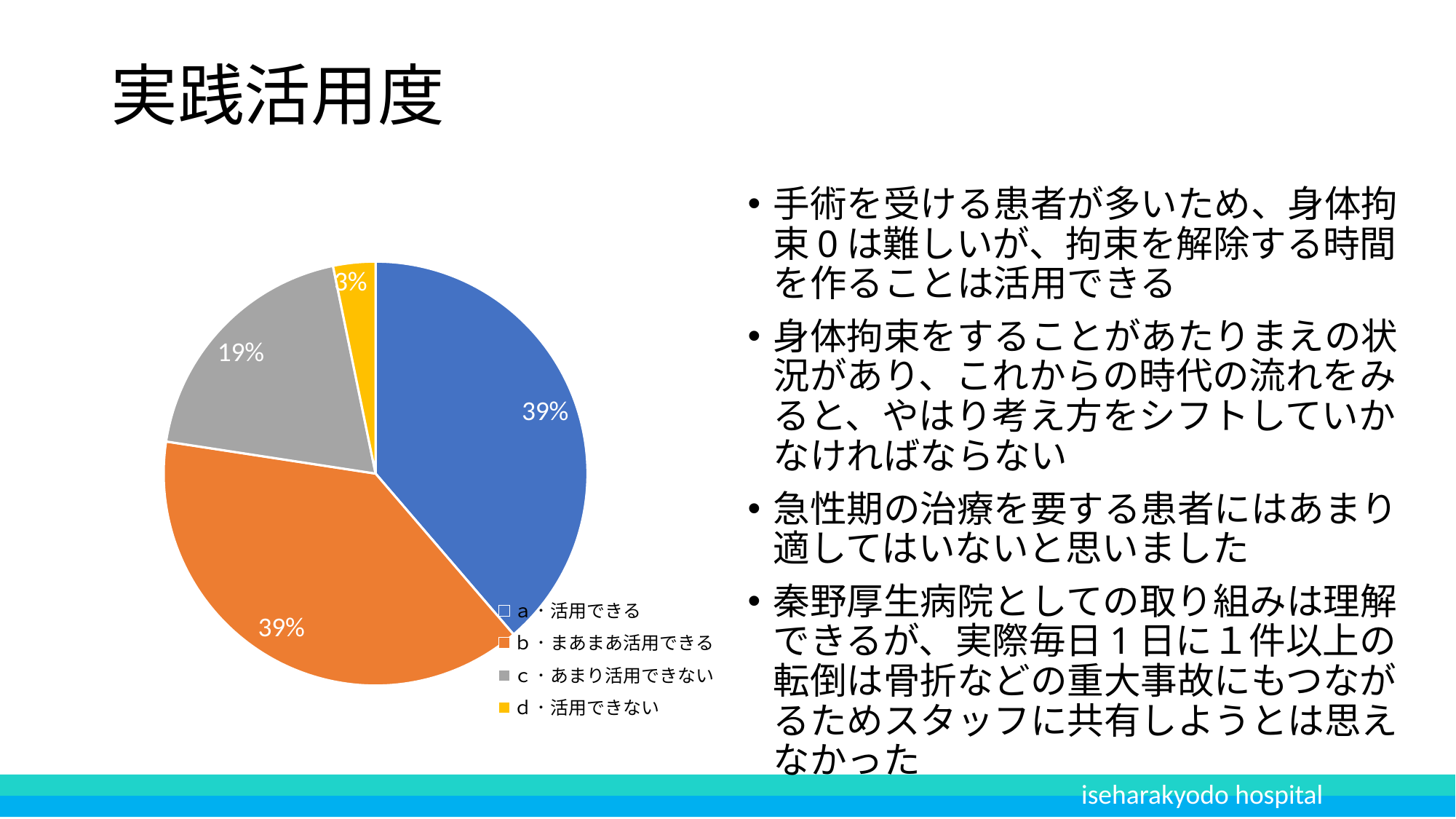
What percentage of the pie is labelled for 'b・まあまあ活用できる'? 39% How many slices does the pie chart have? 4 What percentage of the pie is labelled for 'c・あまり活用できない'? 19% What percentage of the pie is labelled for 'a・活用できる'? 39% How many entries does the legend list? 4 Which category has the smallest slice of the pie? d・活用できない What is the difference in percentage points between 'a・活用できる' and 'c・あまり活用できない'? 20 Which slice is larger, 'c・あまり活用できない' or 'd・活用できない'? c・あまり活用できない What percentage of the pie is labelled for 'd・活用できない'? 3% What colour is the slice for 'd・活用できない'? yellow What kind of chart is shown on the slide? pie chart What is the difference in percentage points between 'c・あまり活用できない' and 'd・活用できない'? 16